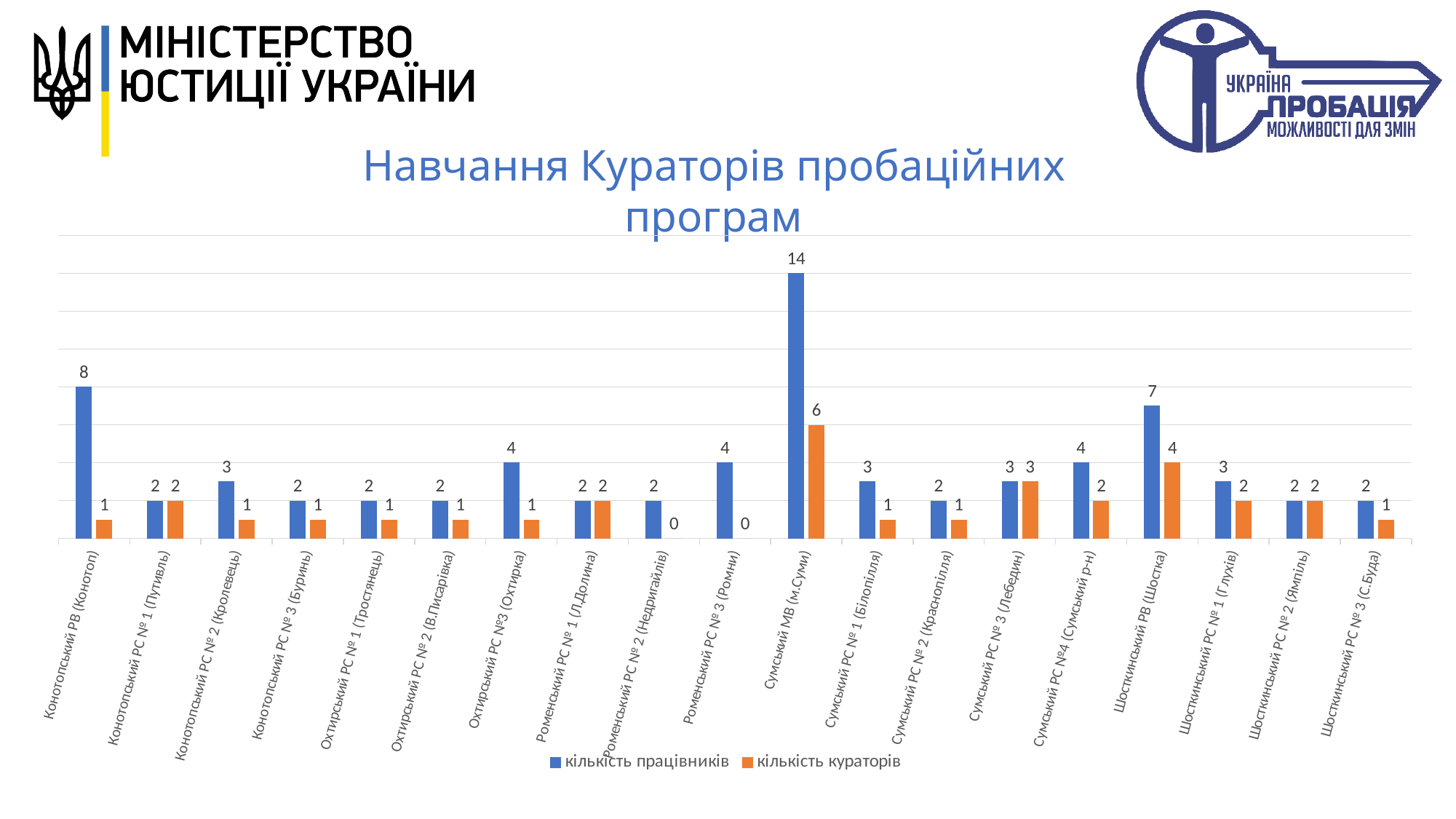
Which category has the highest value of кількість працівників? Сумський МВ (м.Суми) How many series does the legend list? 2 What is the value of кількість кураторів for Роменський РС № 3 (Ромни)? 0 What is the difference in кількість працівників between Сумський МВ (м.Суми) and Шосткинський РВ (Шостка)? 7 Which category has the highest value of кількість кураторів? Сумський МВ (м.Суми) What is the value of кількість кураторів for Шосткинський РВ (Шостка)? 4 Which is larger for Сумський РС №4 (Сумський р-н): кількість працівників or кількість кураторів? кількість працівників What is the difference between кількість працівників and кількість кураторів for Конотопський РВ (Конотоп)? 7 What type of chart is shown on the slide? bar chart What is the value of кількість працівників for Сумський МВ (м.Суми)? 14 What is the title of the chart? Навчання Кураторів пробаційних програм How many categories are shown on the x axis? 19